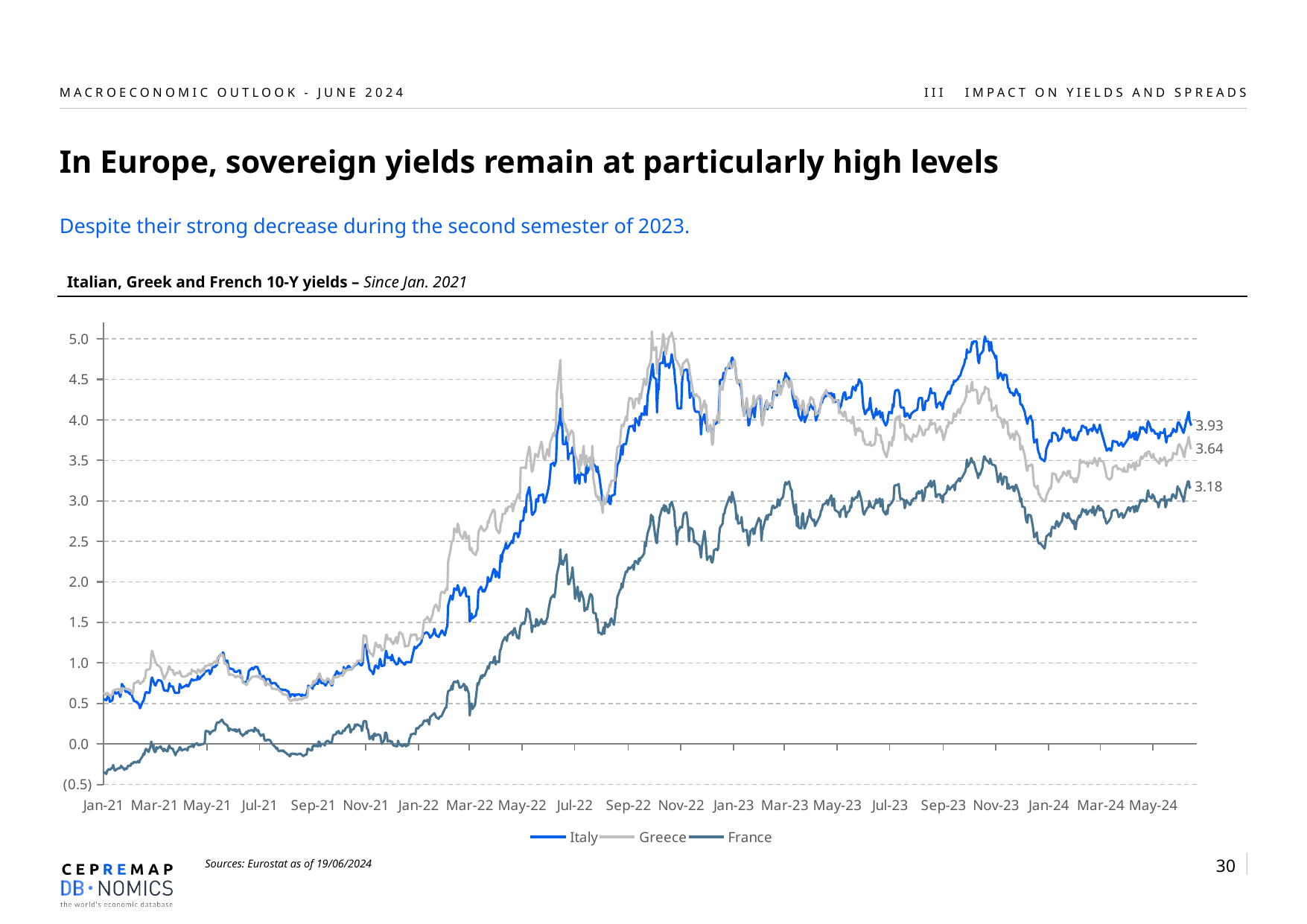
What is the difference between the latest Italy value and the latest France value? 0.75 Which series has the highest value at the end of the chart? Italy What kind of chart is shown on the slide? Line chart What is the latest value shown for the Italy series? 3.93 Is the value for France in Jan-21 greater or less than 0.0? less Which series has the lowest value at the end of the chart? France At the end of the chart, is the Greece value larger or the France value larger? Greece What is the latest value shown for the Greece series? 3.64 Does the Italy series rise or fall between Jan-21 and Jan-23? Rise What is the difference between the latest Italy value and the latest Greece value? 0.29 What is the latest value shown for the France series? 3.18 How many series does the legend list? 3